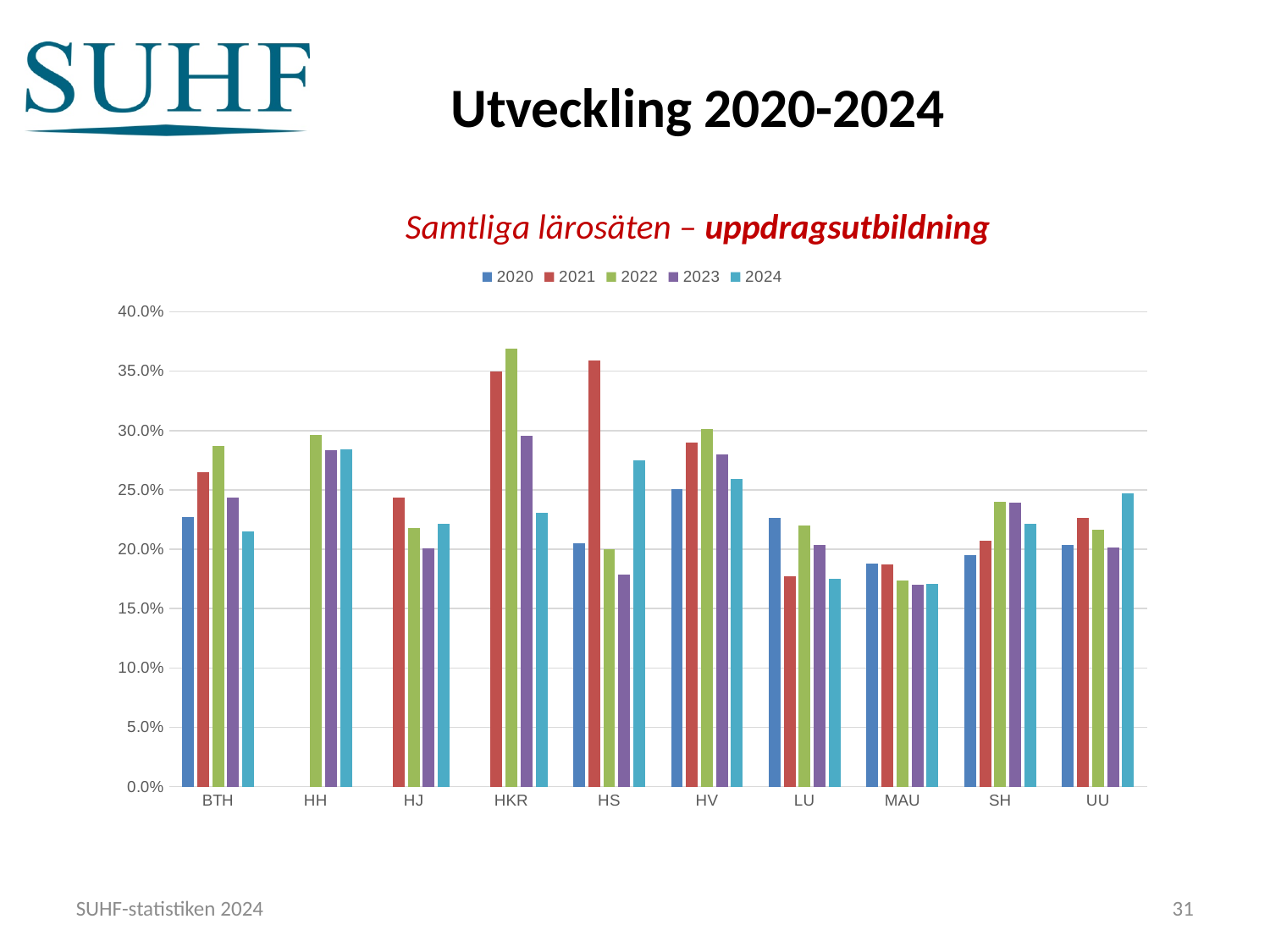
How many categories (institutions) are shown on the x axis? 10 Is the 2021 value for HS greater or less than 30.0%? greater What kind of chart is shown on the slide? bar chart Is the 2022 value for HKR greater or less than 35.0%? greater Is the 2024 value for MAU greater or less than 20.0%? less Which institution has the highest value for 2022? HKR For HKR, which is larger: the 2023 value or the 2024 value? 2023 Which institution has the lowest value for 2022? MAU Which institution has the highest value for 2020? HV For HS, which is larger: the 2021 value or the 2022 value? 2021 How many series does the legend list? 5 Which years have no bar shown for HH? 2020 and 2021